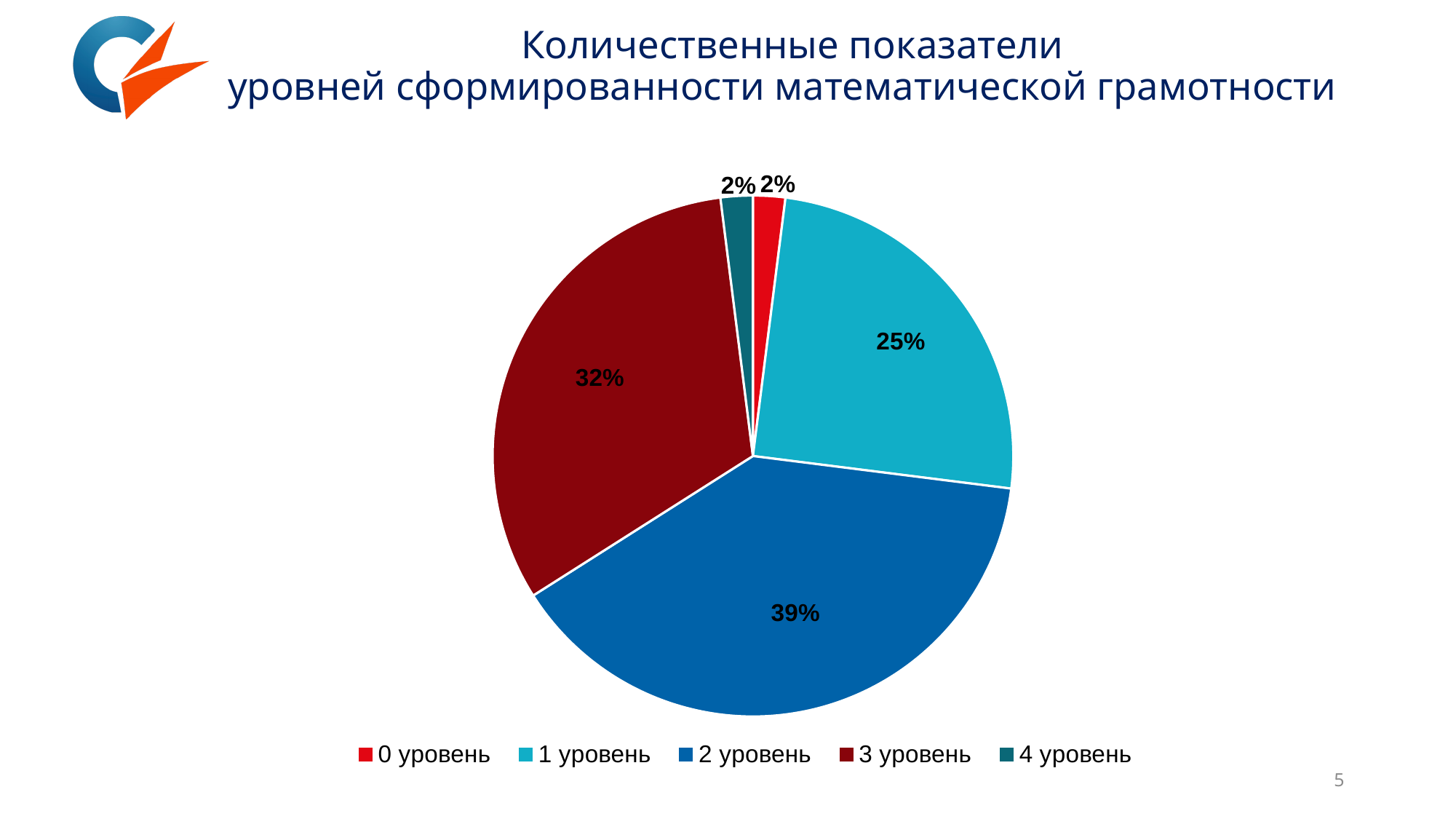
Which level has the largest share of the pie? 2 уровень Which legend entry is shown in dark red? 3 уровень How many slices does the pie chart have? 5 What kind of chart is shown on the slide? pie chart What is the value shown for 4 уровень? 2% What is the difference between the shares of 3 уровень and 1 уровень? 7% What is the difference between the shares of 2 уровень and 3 уровень? 7% What is the value shown for 1 уровень? 25% What is the value shown for 3 уровень? 32% What share of the pie does 2 уровень have? 39% Which is larger, the share of 1 уровень or the share of 3 уровень? 3 уровень What is the value shown for 0 уровень? 2%